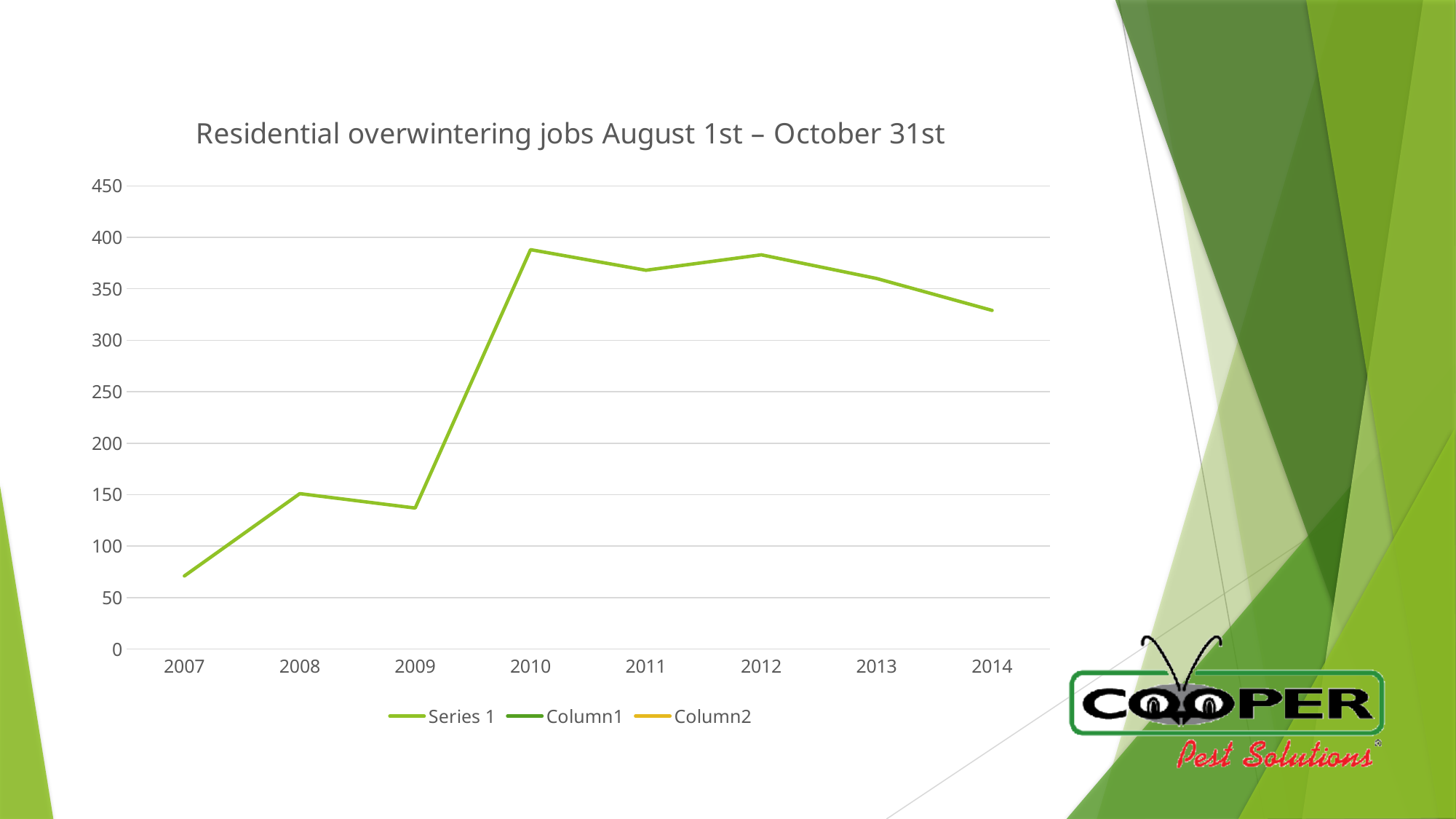
How many series does the legend list? 3 Which year has the lowest value? 2007 Is the value for 2009 greater or less than 200? less How many years are plotted along the x axis? 8 Do the values rise or fall from 2012 to 2014? fall Is the value for 2014 greater or less than 350? less What kind of chart is shown on the slide? line chart Which is larger, the value for 2009 or the value for 2010? 2010 Is the value for 2010 greater or less than 350? greater What is the title of the chart? Residential overwintering jobs August 1st – October 31st Which is larger, the value for 2013 or the value for 2014? 2013